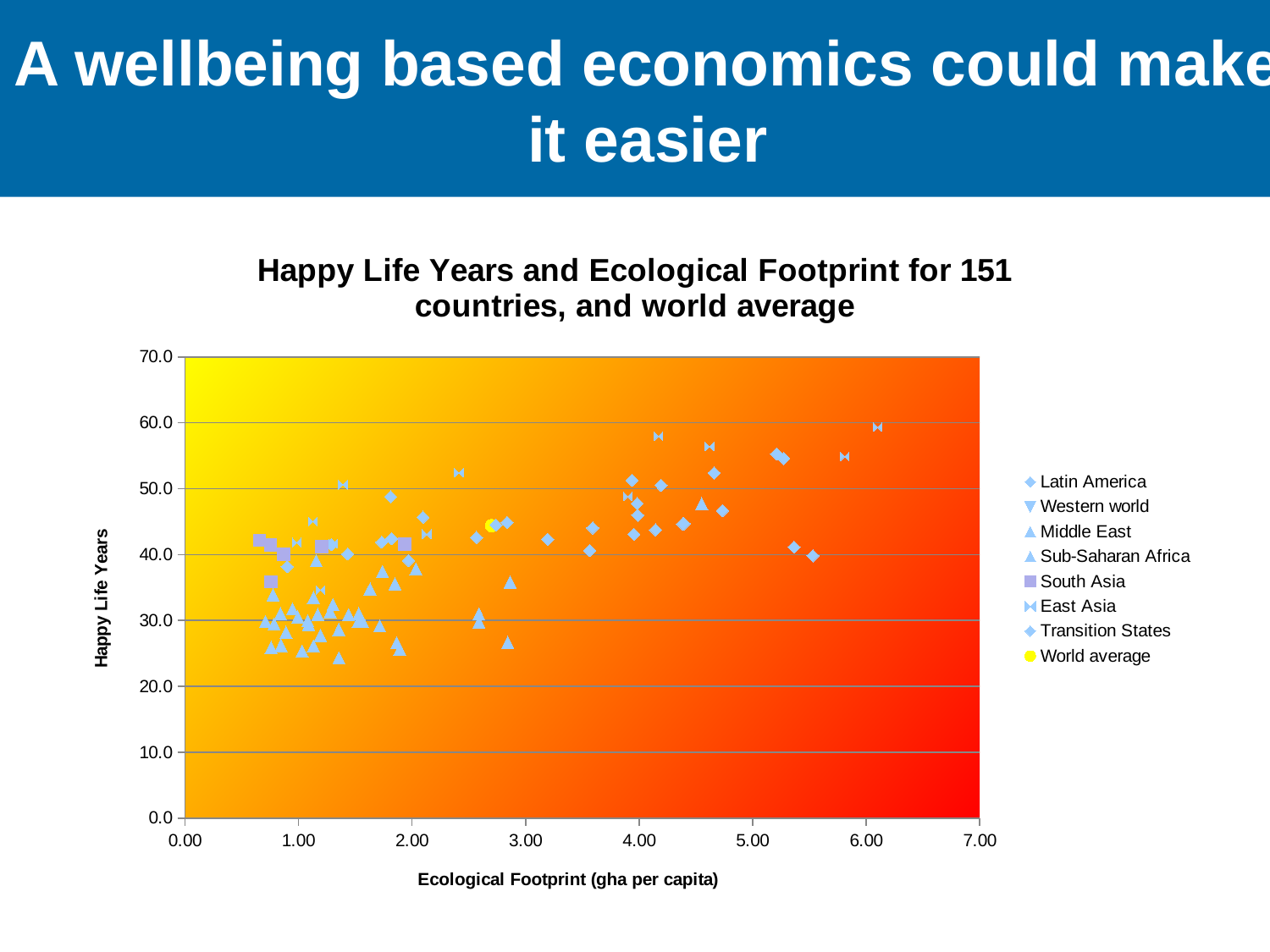
Is the Happy Life Years value for the World average point greater or less than 40.0? greater How many series does the chart's legend list? 8 Do Happy Life Years values generally rise or fall as Ecological Footprint increases along the x axis? rise Is the Happy Life Years value for the World average point greater or less than 50.0? less What is the title of the chart? Happy Life Years and Ecological Footprint for 151 countries, and world average What is the label of the horizontal axis? Ecological Footprint (gha per capita) Is the Ecological Footprint value for the World average point greater or less than 3.00? less What kind of chart is shown on the slide? scatter chart